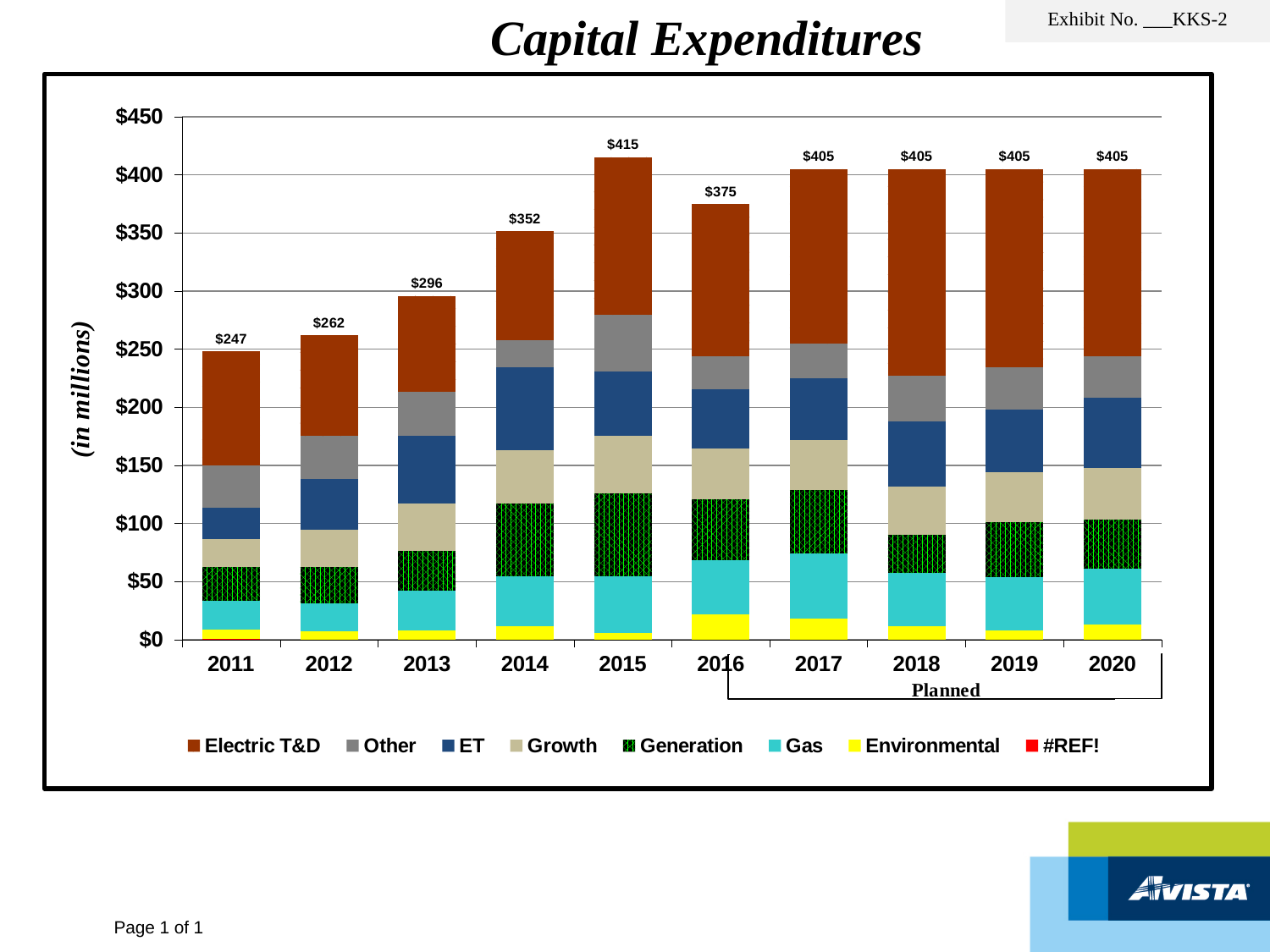
How many series does the legend list? 8 What is the total capital expenditure shown for 2015? $415 What is the total capital expenditure shown for 2016? $375 How many years are shown on the x axis? 10 What kind of chart is shown on the slide? Stacked bar chart Which years are grouped under the label "Planned"? 2016 to 2020 In 2014, is the boundary between the Growth and ET segments greater or less than $150? greater Which year has the highest total capital expenditure? 2015 Which year has a larger total, 2013 or 2016? 2016 What is the total capital expenditure shown for 2011? $247 Which year has the lowest total capital expenditure? 2011 What is the difference between the total for 2015 and the total for 2014? $63